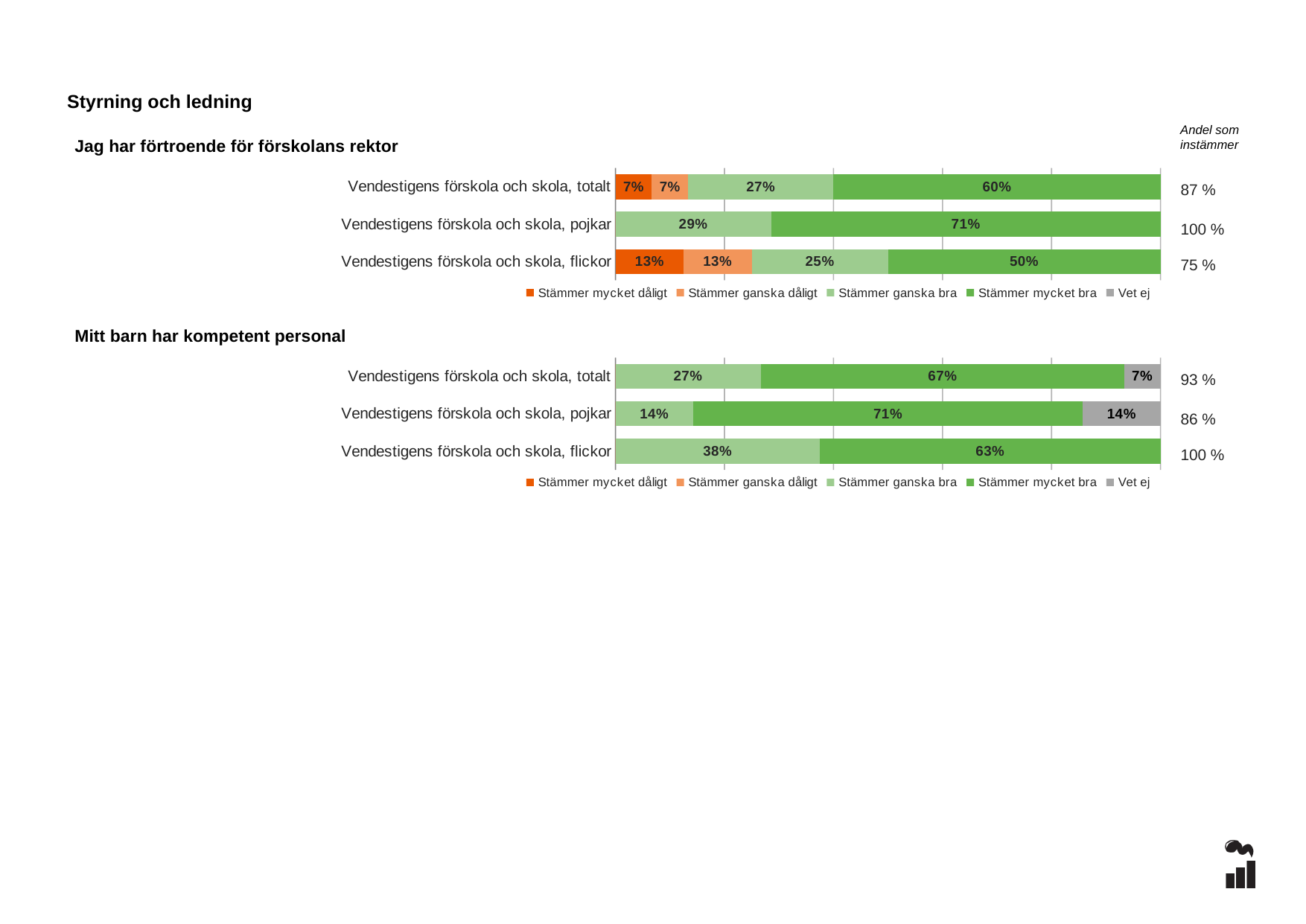
In the chart 'Mitt barn har kompetent personal', what is the 'Stämmer ganska bra' value for 'Vendestigens förskola och skola, flickor'? 38% How many categories are shown in the chart 'Mitt barn har kompetent personal'? 3 In the chart 'Jag har förtroende för förskolans rektor', what is the 'Stämmer mycket bra' value for 'Vendestigens förskola och skola, totalt'? 60% In the chart 'Mitt barn har kompetent personal', what is the 'Vet ej' value for 'Vendestigens förskola och skola, pojkar'? 14% In the chart 'Jag har förtroende för förskolans rektor', which category has the highest 'Stämmer mycket bra' value? Vendestigens förskola och skola, pojkar In the chart 'Jag har förtroende för förskolans rektor', what is the difference between the 'Stämmer mycket bra' values for pojkar and flickor? 21% In the chart 'Jag har förtroende för förskolans rektor', what is the 'Stämmer ganska bra' value for 'Vendestigens förskola och skola, pojkar'? 29% How many series does the legend of the chart 'Jag har förtroende för förskolans rektor' list? 5 In the chart 'Jag har förtroende för förskolans rektor', what is the 'Stämmer mycket dåligt' value for 'Vendestigens förskola och skola, flickor'? 13% What kind of chart is 'Jag har förtroende för förskolans rektor'? Stacked bar chart In the chart 'Mitt barn har kompetent personal', which category has the lowest 'Stämmer ganska bra' value? Vendestigens förskola och skola, pojkar In the chart 'Mitt barn har kompetent personal', which is larger: the 'Stämmer mycket bra' value for totalt or for flickor? totalt